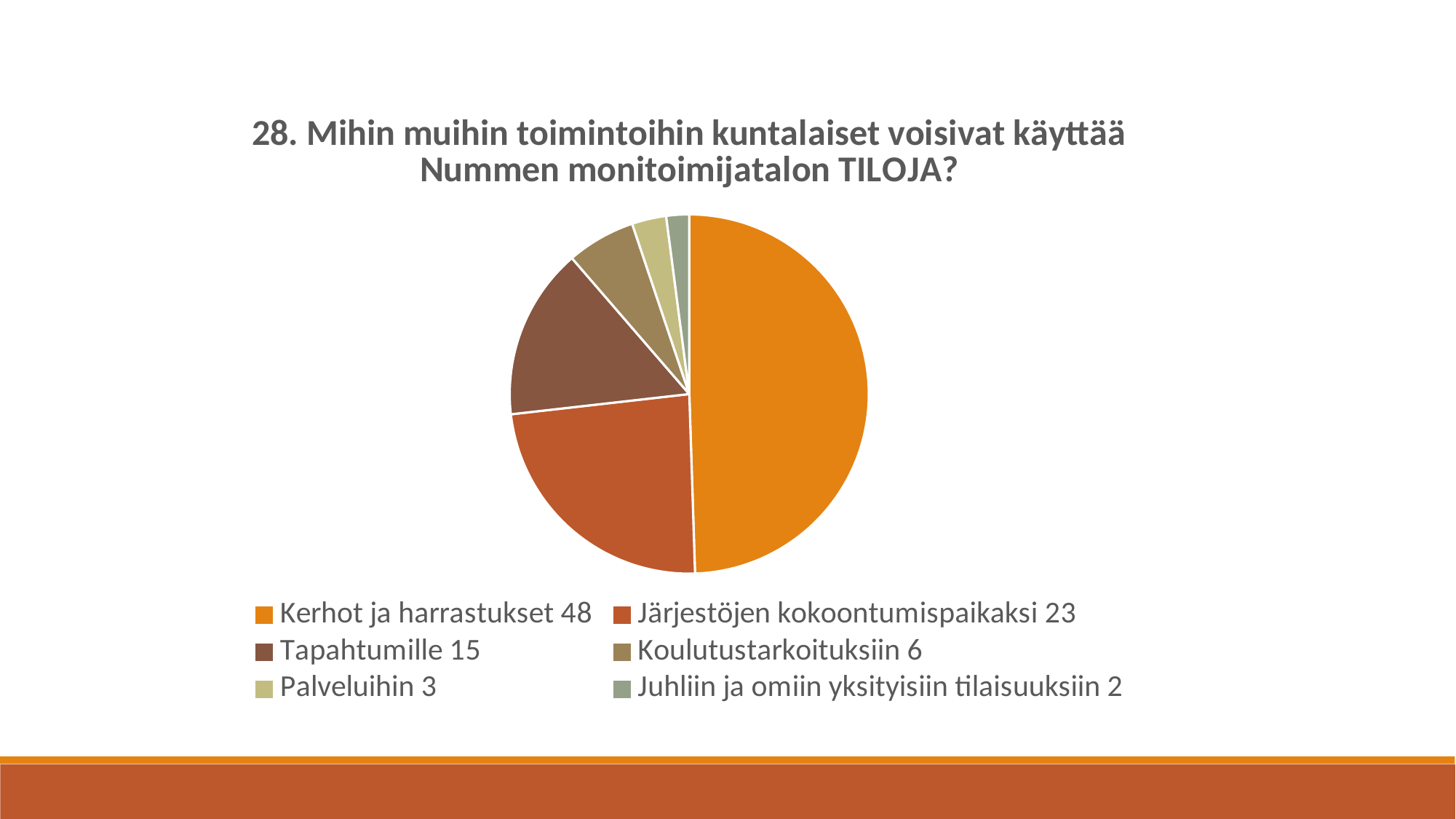
What is the difference between the values for Kerhot ja harrastukset and Järjestöjen kokoontumispaikaksi? 25 Which category has the smallest slice of the pie? Juhliin ja omiin yksityisiin tilaisuuksiin What kind of chart is shown on the slide? pie chart Which category has the largest slice of the pie? Kerhot ja harrastukset What is the value for Järjestöjen kokoontumispaikaksi? 23 What is the value for Tapahtumille? 15 How many categories does the pie chart have? 6 What is the total of all the values shown in the pie chart? 97 What colour is the slice for Kerhot ja harrastukset? orange What is the value for Kerhot ja harrastukset? 48 What is the value for Koulutustarkoituksiin? 6 Which is larger, the value for Tapahtumille or the value for Koulutustarkoituksiin? Tapahtumille